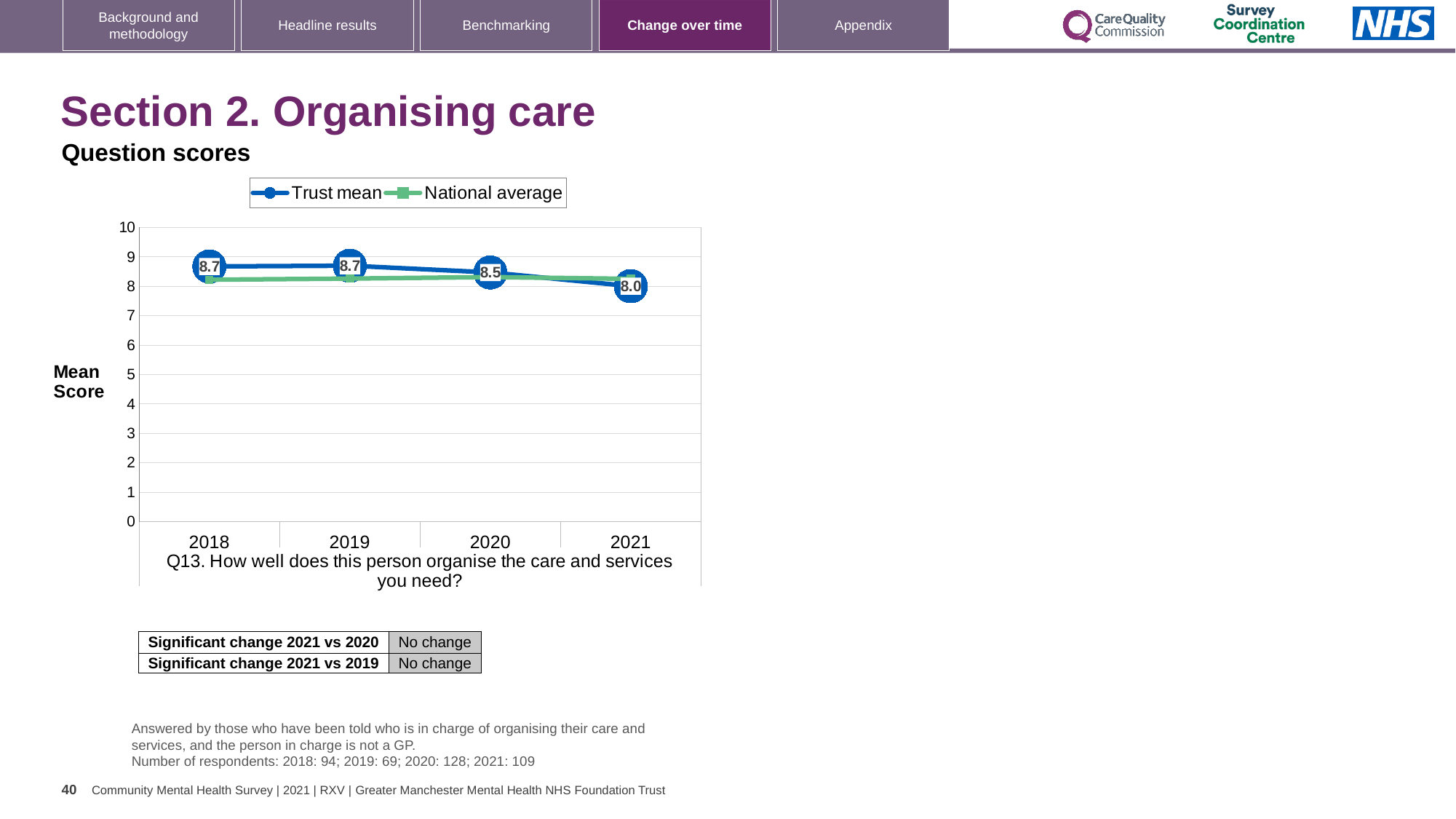
How many years are shown on the x axis of the chart? 4 What is the difference between the Trust mean score in 2018 and in 2021? 0.7 What kind of chart is shown on the slide? Line chart What is the Trust mean score for 2018? 8.7 In which year is the Trust mean score lowest? 2021 Is the National average value for 2018 greater or less than 9? less What are the two series named in the chart legend? Trust mean and National average Does the Trust mean score rise or fall from 2018 to 2021? Fall What is the Trust mean score for 2021? 8.0 How many series does the chart legend list? 2 What is the Trust mean score for 2020? 8.5 Which is larger, the Trust mean score in 2019 or in 2021? 2019